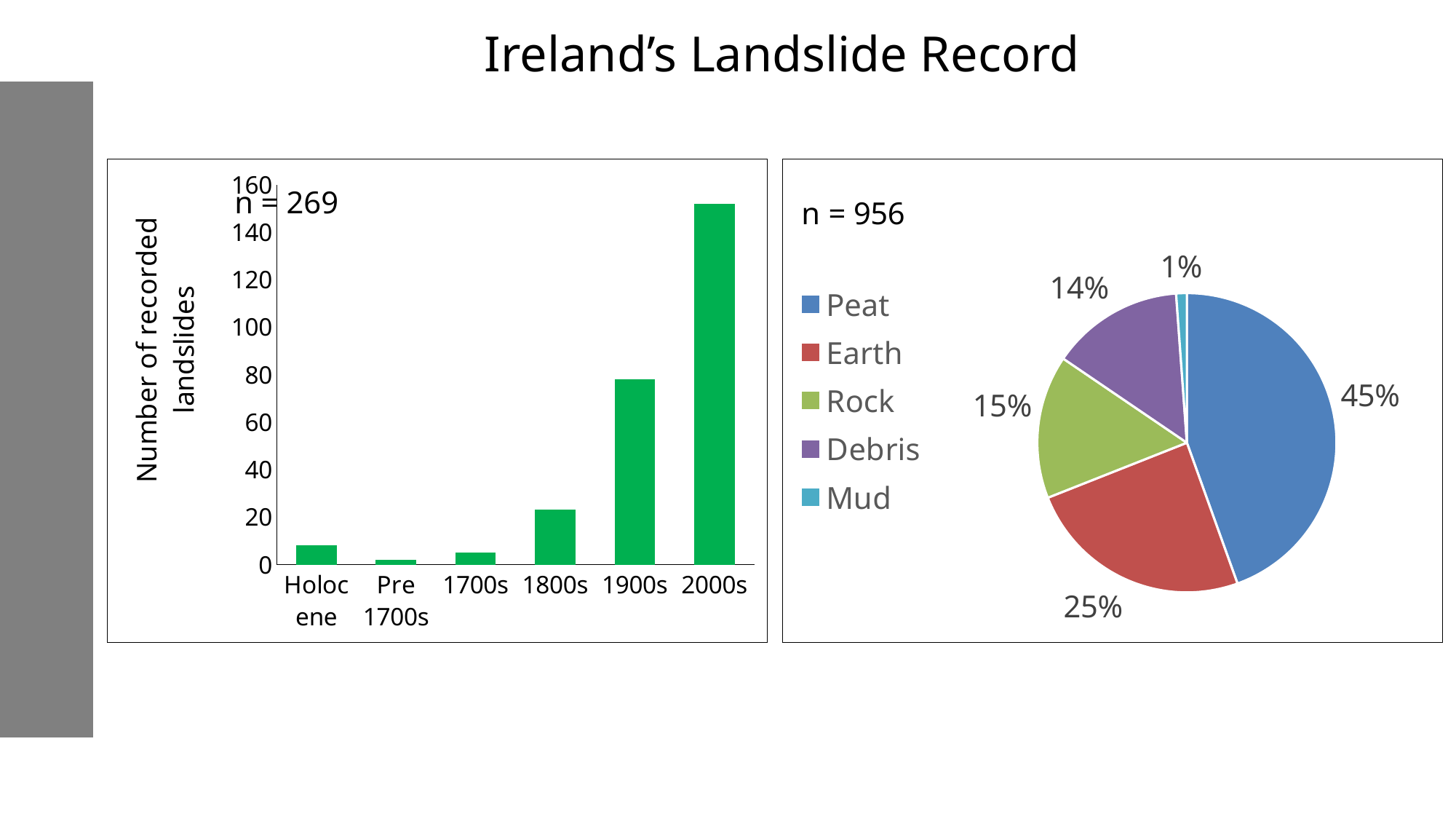
In the left bar chart, is the value for the 2000s greater or less than 140? greater How many periods are shown on the x axis of the left bar chart? 6 In the left bar chart, which period has the lowest number of recorded landslides? Pre 1700s In the left bar chart, is the value for the 1800s greater or less than 40? less In the left bar chart, do the values rise or fall from the 1700s to the 2000s? rise In the left bar chart, which period has the highest number of recorded landslides? 2000s In the right pie chart, what is the difference between the Earth share and the Rock share? 10% How many categories does the legend of the right pie chart list? 5 What type of chart is the chart on the right of the slide? pie chart In the left bar chart, is the value for the 1900s greater or less than 100? less What type of chart is the chart on the left of the slide? bar chart In the right pie chart, what share of landslides is Peat? 45%